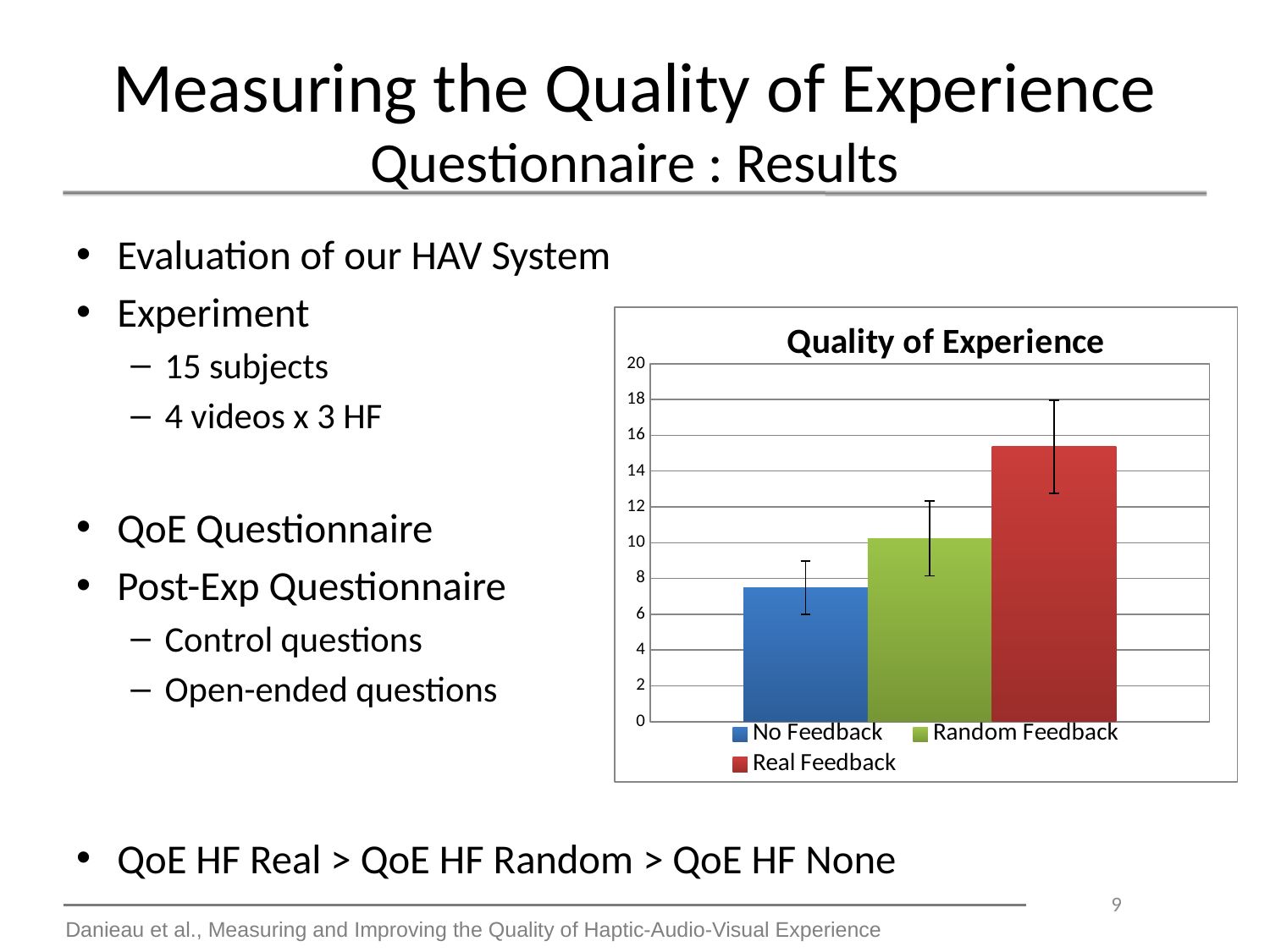
Which is larger, the value for Real Feedback or the value for Random Feedback? Real Feedback Is the value for Random Feedback greater or less than 12? less Which is larger, the value for Random Feedback or the value for No Feedback? Random Feedback Do the bar values rise or fall from No Feedback to Real Feedback? rise Which series has the highest value in the Quality of Experience chart? Real Feedback What kind of chart is shown on the slide? bar chart Is the value for No Feedback greater or less than 8? less Which series has the lowest value in the Quality of Experience chart? No Feedback What is the title of the chart? Quality of Experience Is the value for Real Feedback greater or less than 14? greater What colour is the Real Feedback bar? red How many series does the chart legend list? 3